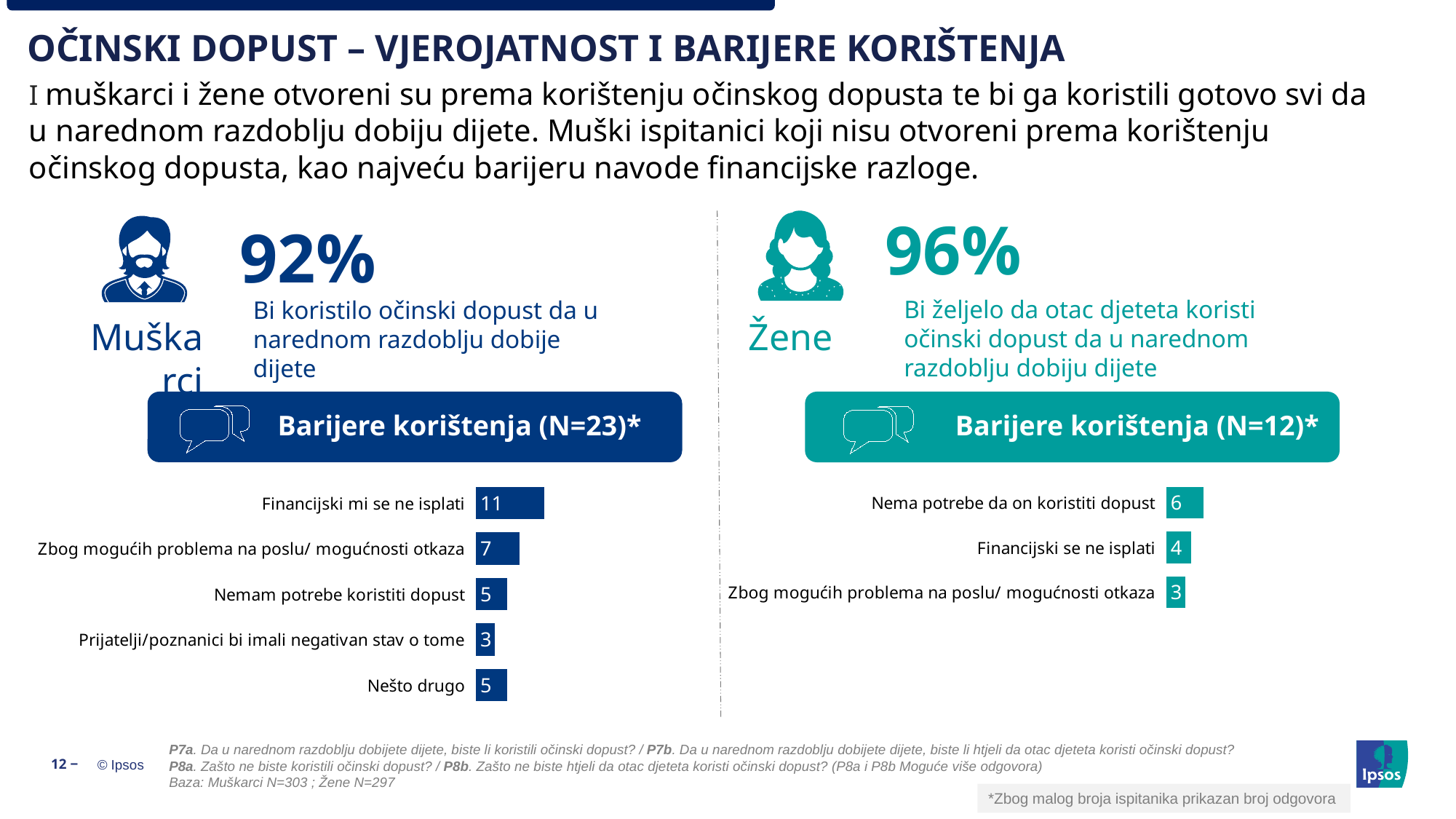
In the right chart (Barijere korištenja, N=12), which category has the highest value? Nema potrebe da on koristiti dopust In the left chart (Barijere korištenja, N=23), what is the value for "Financijski mi se ne isplati"? 11 What type of chart is the left chart (Barijere korištenja, N=23)? Bar chart How many categories are shown in the right chart (Barijere korištenja, N=12)? 3 In the right chart (Barijere korištenja, N=12), what is the value for "Nema potrebe da on koristiti dopust"? 6 In the left chart (Barijere korištenja, N=23), which category has the highest value? Financijski mi se ne isplati In the right chart (Barijere korištenja, N=12), what is the value for "Zbog mogućih problema na poslu/ mogućnosti otkaza"? 3 In the left chart (Barijere korištenja, N=23), what is the difference between "Financijski mi se ne isplati" and "Nemam potrebe koristiti dopust"? 6 How many categories are shown in the left chart (Barijere korištenja, N=23)? 5 In the left chart (Barijere korištenja, N=23), which category has the lowest value? Prijatelji/poznanici bi imali negativan stav o tome In the left chart (Barijere korištenja, N=23), what is the value for "Zbog mogućih problema na poslu/ mogućnosti otkaza"? 7 In the right chart (Barijere korištenja, N=12), what is the difference between "Nema potrebe da on koristiti dopust" and "Financijski se ne isplati"? 2